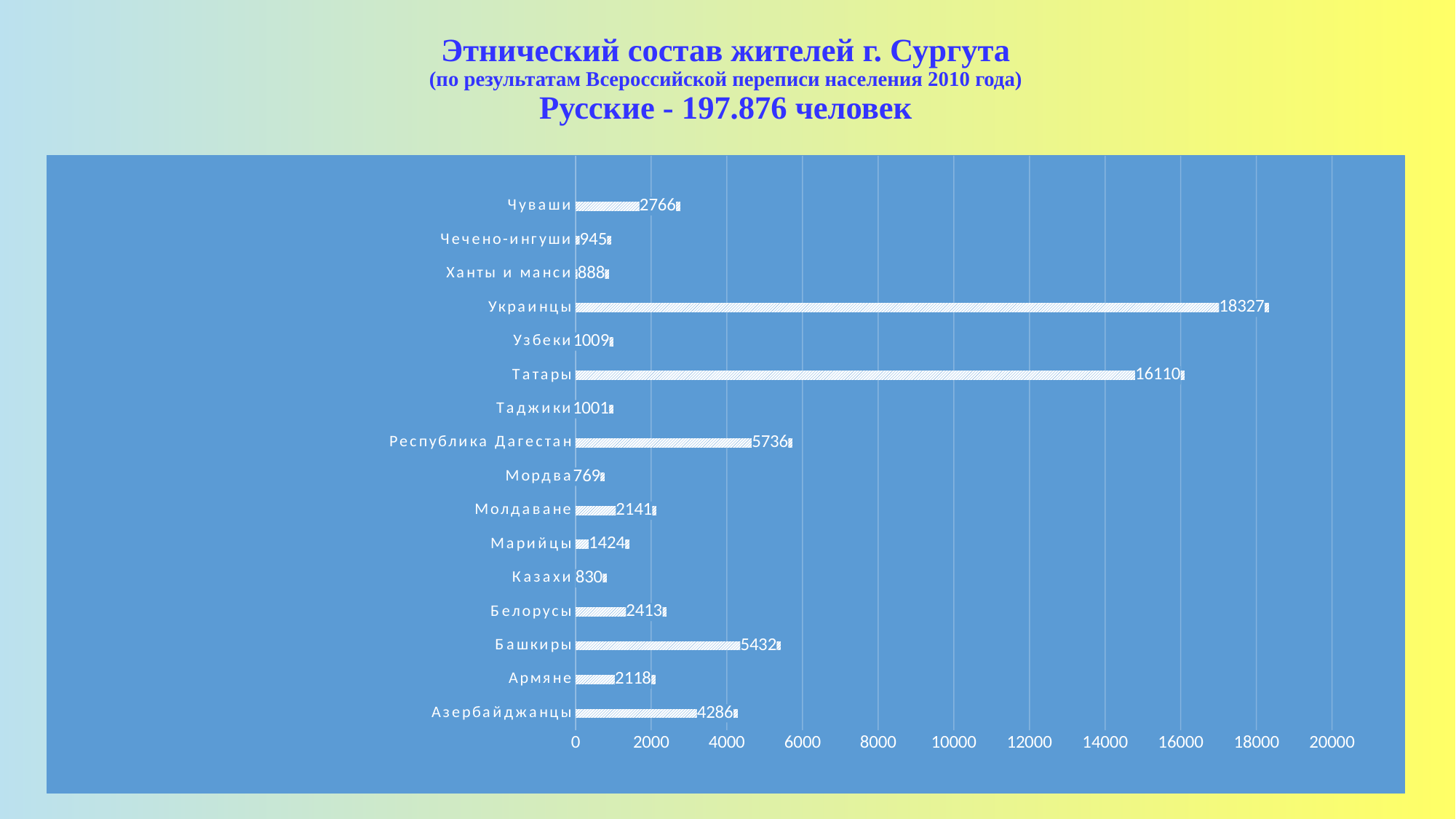
What is the value for Мордва? 769 What is the value for Башкиры? 5432 Which category has the highest value? Украинцы What is the difference between the values for Украинцы and Татары? 2217 How many categories are shown in the chart? 16 What is the value for Татары? 16110 Which category has the lowest value? Мордва Which is larger, the value for Азербайджанцы or the value for Чуваши? Азербайджанцы What is the title of the slide? Этнический состав жителей г. Сургута What kind of chart is shown on the slide? Bar chart What is the difference between the values for Республика Дагестан and Башкиры? 304 What is the value for Украинцы? 18327